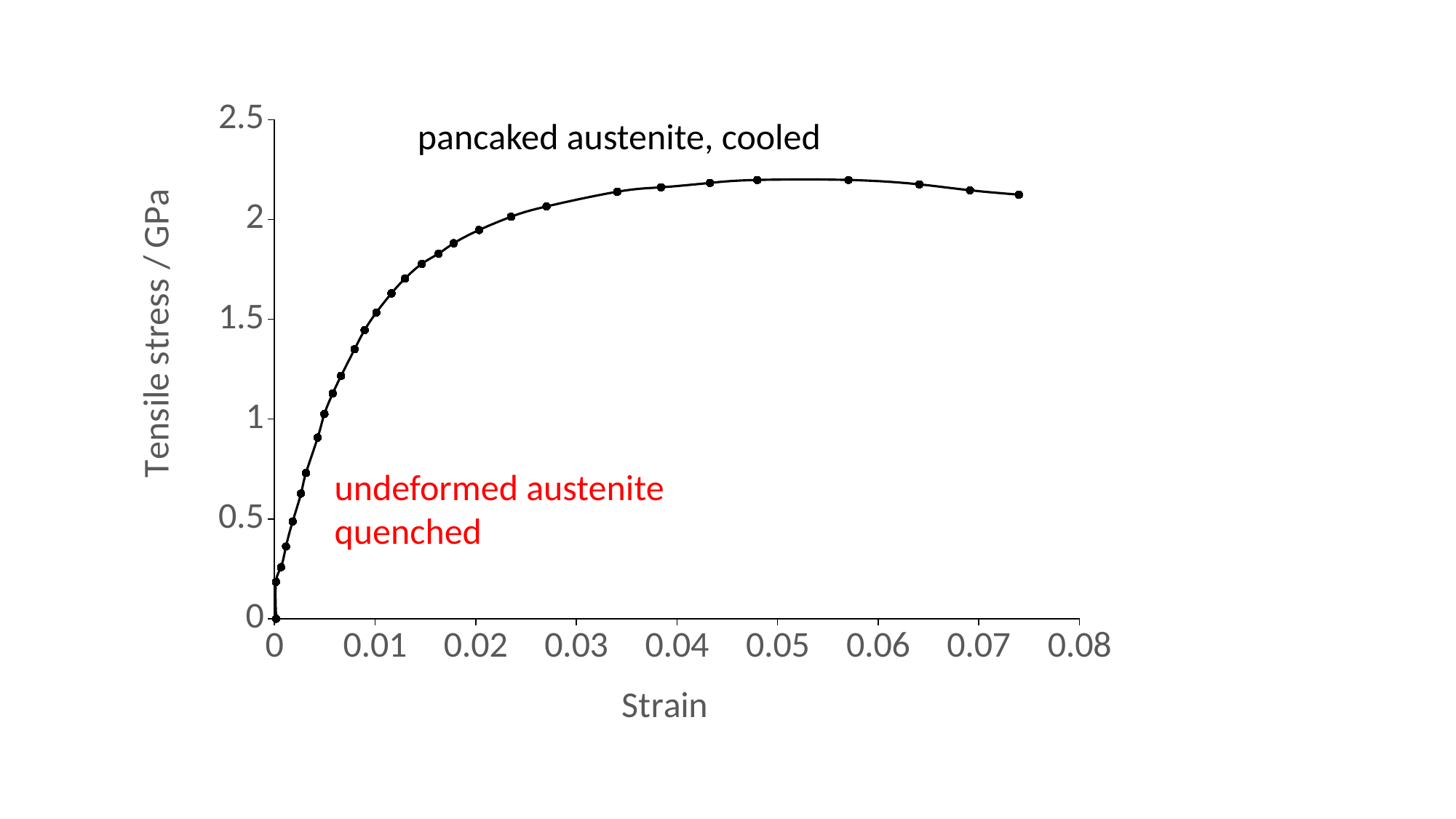
Is the tensile stress at a strain of 0.03 greater or less than 2 GPa? greater Is the tensile stress at a strain of 0.002 greater or less than 1 GPa? less What is the label of the x axis? Strain Does the tensile stress rise or fall as strain increases from 0 to 0.04? rise What kind of chart is shown on the slide? line chart Does the plotted curve ever exceed 2.5 GPa? No What is the label of the y axis? Tensile stress / GPa What is the highest value shown on the x axis? 0.08 Does the tensile stress rise or fall as strain increases from 0.06 to 0.074? fall